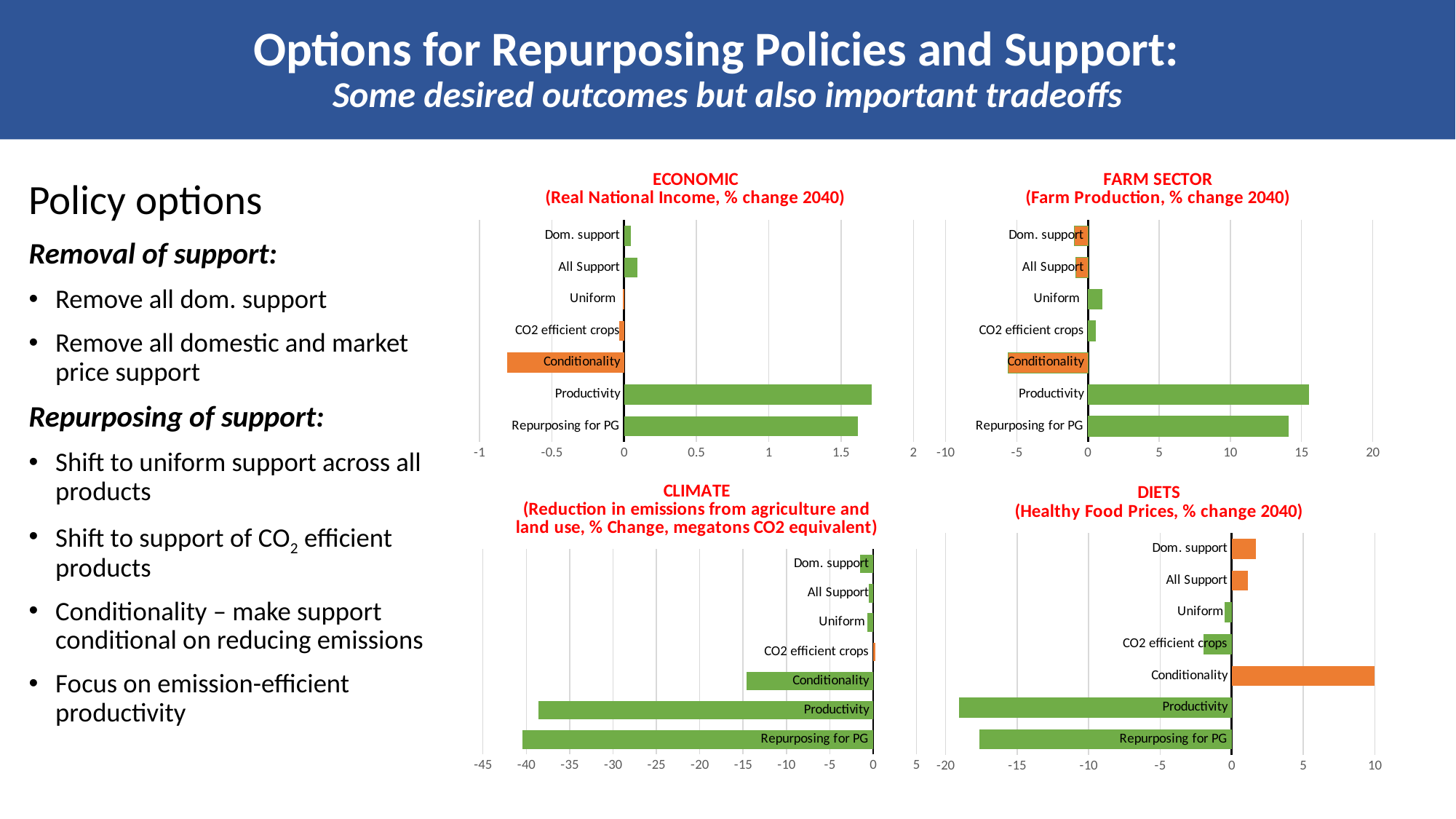
In the ECONOMIC chart, which policy option has the highest value? Productivity In the CLIMATE chart, is the value for Productivity greater or less than -35? less In the FARM SECTOR chart, is the value for Repurposing for PG greater or less than 10? greater In the DIETS chart, which is larger, the value for Dom. support or the value for Conditionality? Conditionality In the ECONOMIC chart, is the value for Productivity greater or less than 1.5? greater In the FARM SECTOR chart, which policy option has the highest value? Productivity In the DIETS chart, which policy option has the highest value? Conditionality In the ECONOMIC chart, which policy option has the lowest value? Conditionality What kind of chart is the ECONOMIC chart? bar chart How many policy options (categories) are plotted in the FARM SECTOR chart? 7 What is the subtitle in parentheses under the DIETS chart title? (Healthy Food Prices, % change 2040)